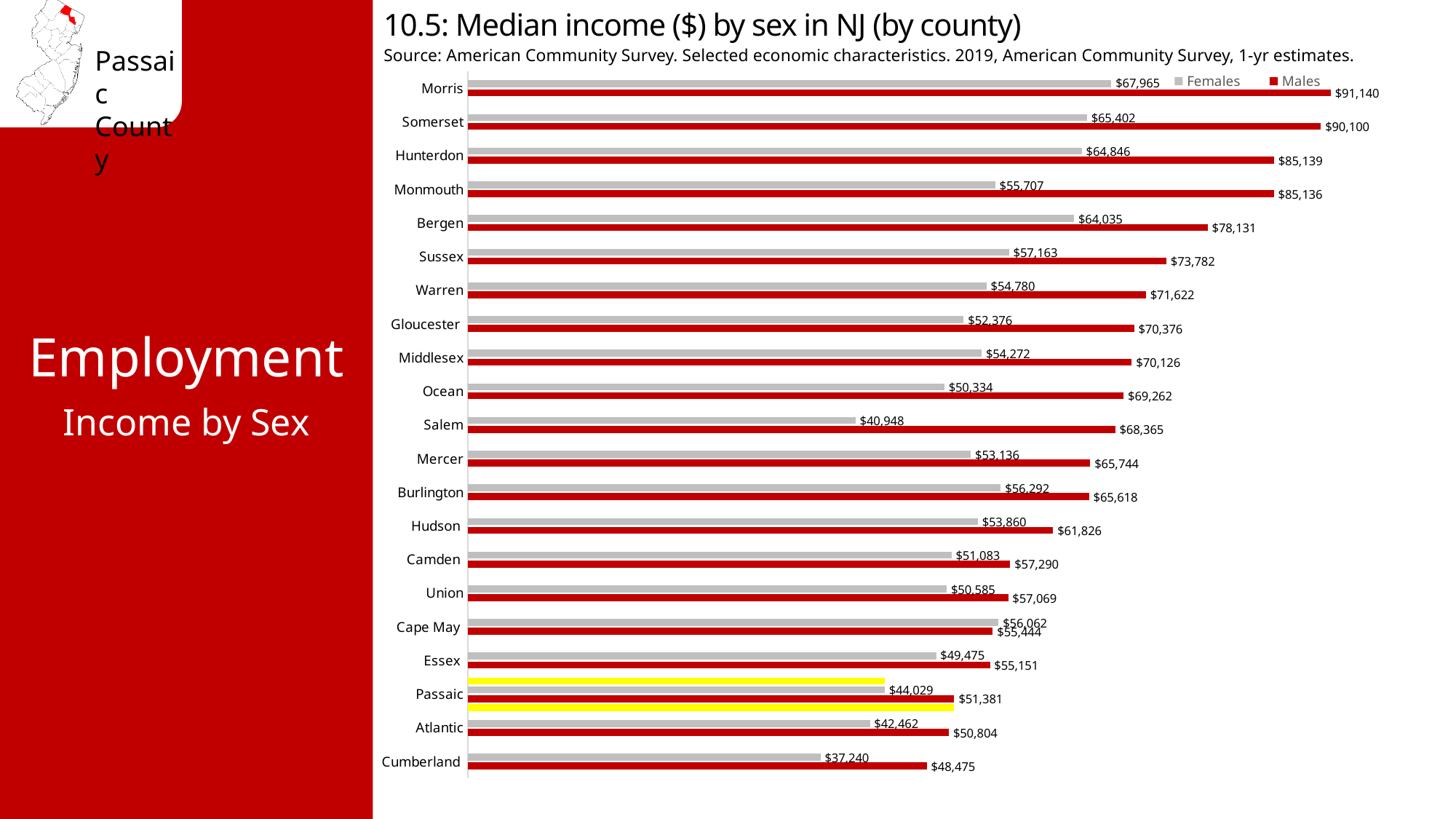
What is the median income for females in Bergen County? $64,035 Which county has the lowest median income for females? Cumberland How many counties are shown in the chart? 21 In Cape May County, which is higher: the female or the male median income? Females What is the difference between the male and female median incomes in Morris County? $23,175 What is the difference between the male and female median incomes in Passaic County? $7,352 What kind of chart is shown on the slide? Bar chart Which county's bars are highlighted in yellow? Passaic Which county has the highest median income for males? Morris How many series does the legend list? 2 What is the median income for females in Passaic County? $44,029 What is the median income for males in Passaic County? $51,381